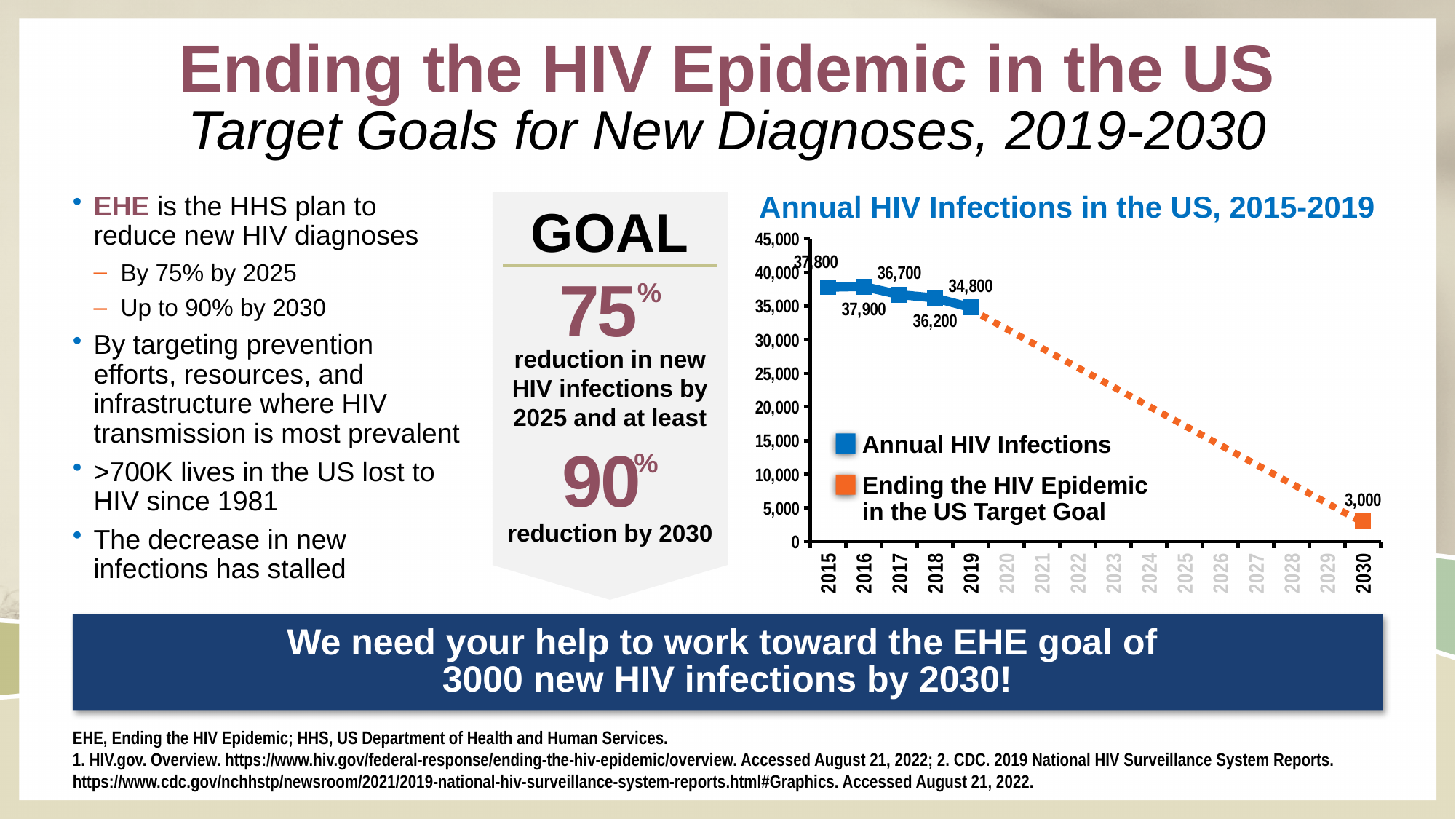
What is the difference between the annual HIV infections in 2016 and 2018? 1,700 What is the Ending the HIV Epidemic in the US Target Goal value shown for 2030? 3,000 Which is larger, the annual HIV infections in 2017 or in 2018? 2017 What is the value for 2017 in the Annual HIV Infections in the US chart? 36,700 What kind of chart is shown on the slide? Line chart Do the annual HIV infections rise or fall from 2016 to 2019? Fall Which year from 2015 to 2019 has the lowest annual HIV infections? 2019 What is the value for 2015 in the Annual HIV Infections in the US chart? 37,800 What is the value for 2019 in the Annual HIV Infections in the US chart? 34,800 How many series does the chart legend list? 2 What is the difference between the annual HIV infections in 2015 and 2019? 3,000 Which year from 2015 to 2019 has the highest annual HIV infections? 2016